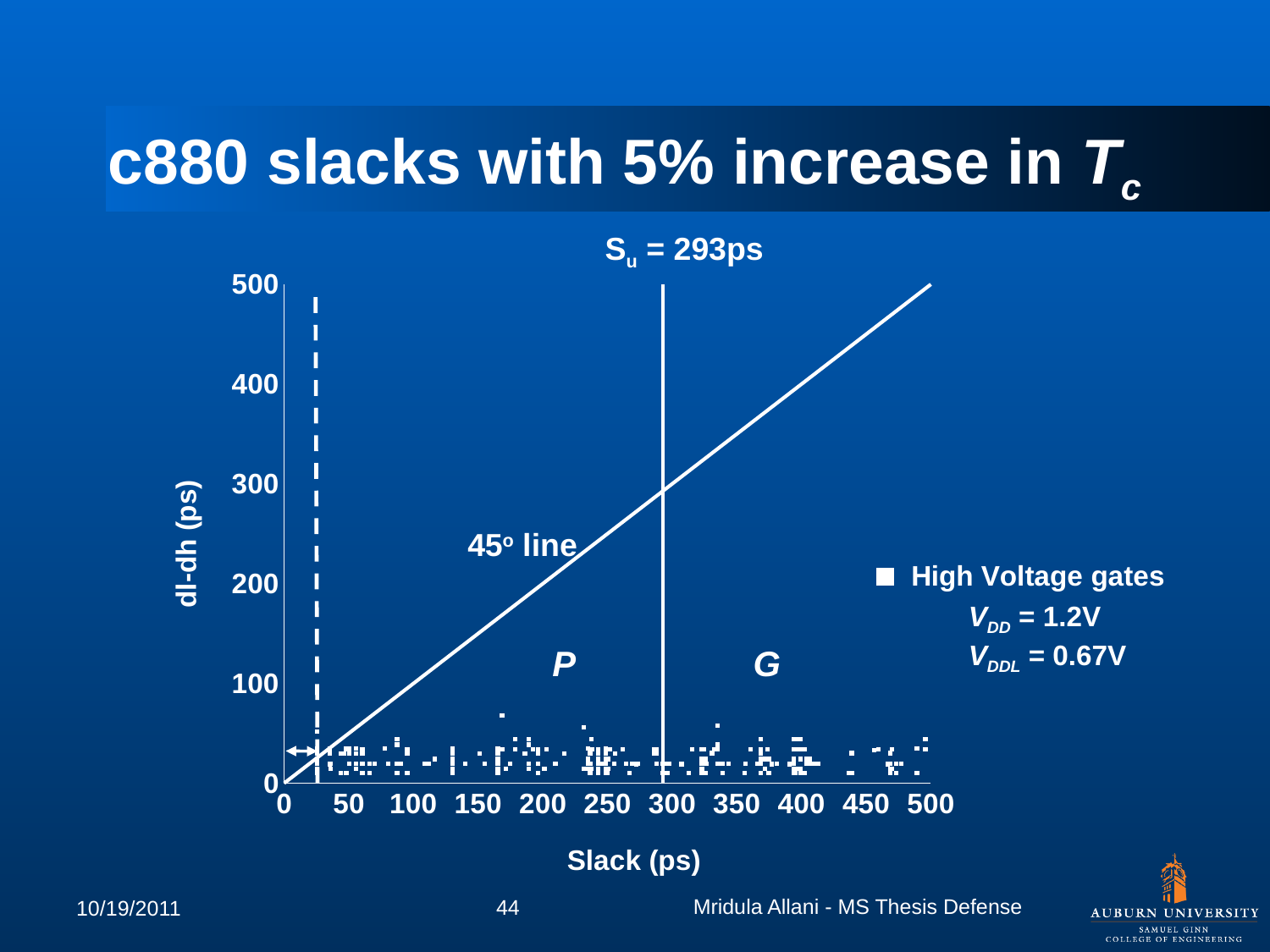
What value of Su is printed above the chart? 293ps What kind of chart is shown on the slide? scatter plot How many tick labels are shown on the x axis? 11 How many series does the legend list? 1 What VDD value is given next to the legend entry for High Voltage gates? 1.2V What VDDL value is given next to the legend entry for High Voltage gates? 0.67V Is the slack value at which the solid vertical line is drawn greater or less than 250? greater What is the label of the x axis? Slack (ps) Are the dl-dh values of the plotted points greater or less than 100? less How many tick labels are shown on the y axis? 6 What is the label of the y axis? dl-dh (ps)